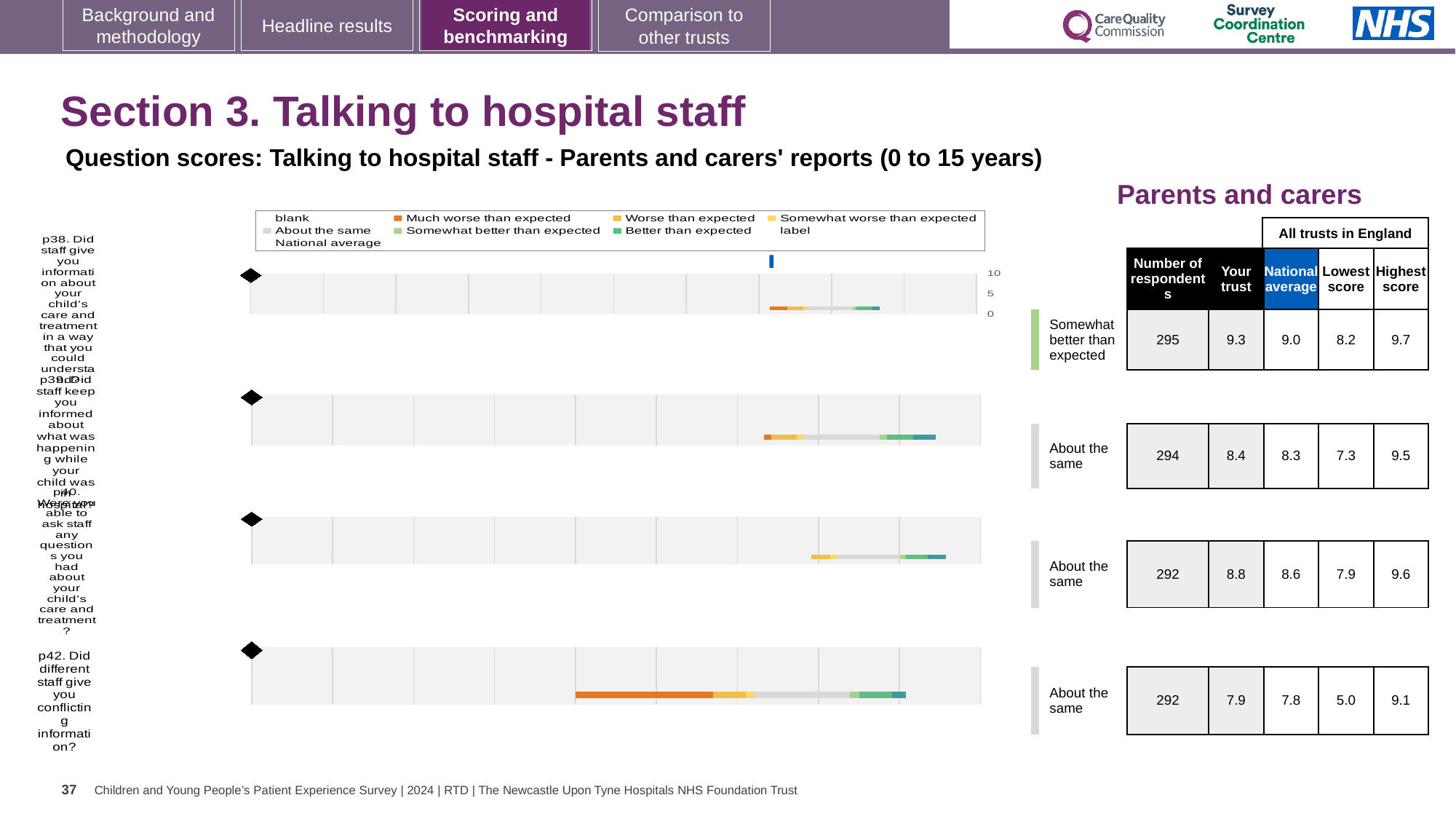
In the table, what is the difference between the highest score and the lowest score for p42? 4.1 Which colour represents 'Much worse than expected' in the legend? orange How many question rows (p38, p39, p40, p42) have a benchmarking bar on this slide? 4 In the table next to the charts, what is the national average for p42 (conflicting information)? 7.8 In the table, which question has the highest 'Your trust' score? p38 How many entries does the legend above the bars list? 9 In the table, which question has the lowest 'Your trust' score? p42 What kind of chart is used to show the question scores on this slide? bar chart In the table, is the 'Your trust' score for p40 larger or smaller than the national average for p40? larger In the table next to the charts, what is the 'Your trust' score for p38 (information about your child's care and treatment)? 9.3 What is the highest tick value shown on the axis of the first bar chart? 10 In the table, how many respondents answered p39? 294